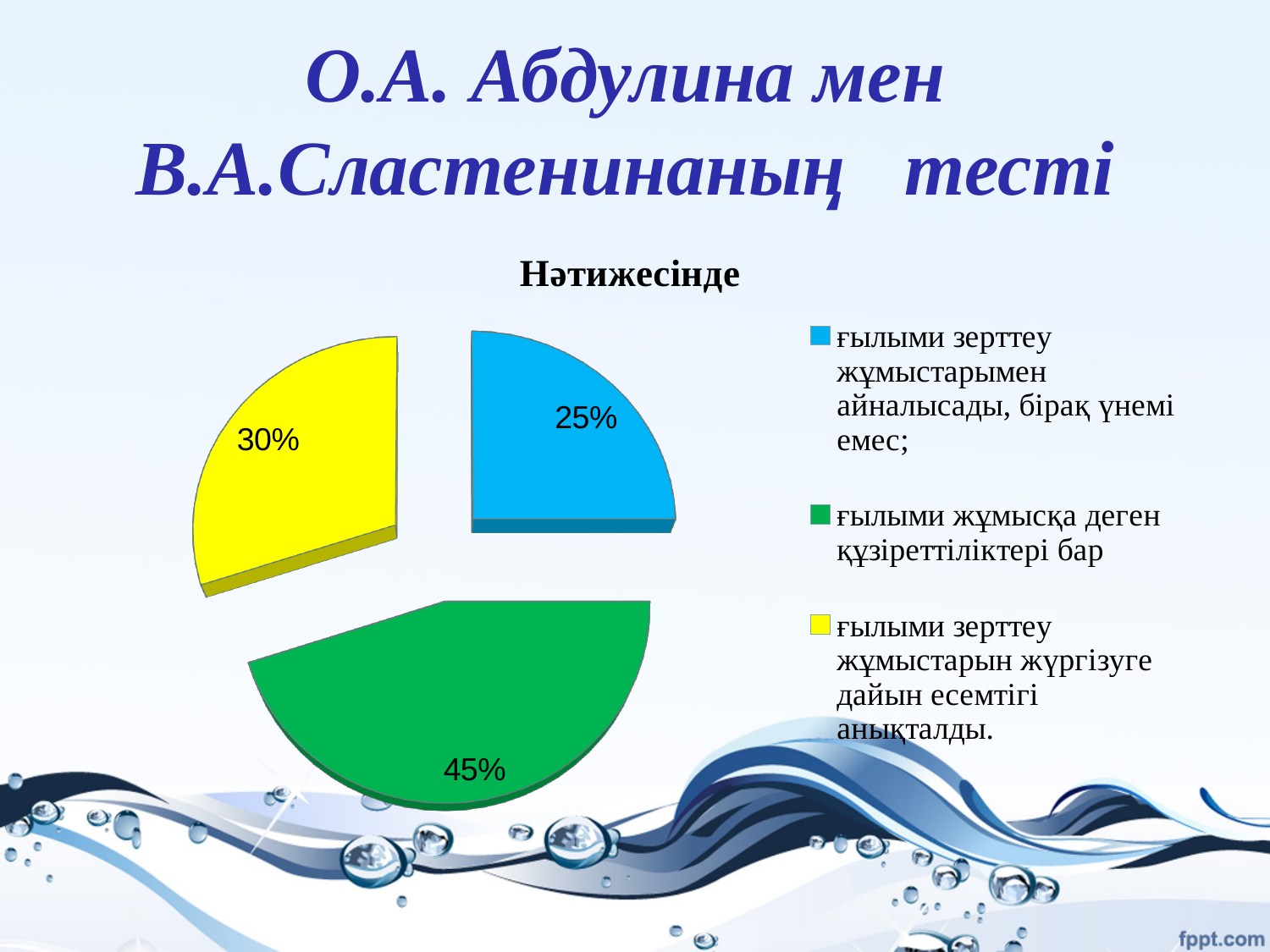
What colour is the slice labelled 45%? Green Which is larger: the yellow slice or the blue slice? The yellow slice (30%) What percentage is shown for the slice "ғылыми жұмысқа деген құзіреттіліктері бар"? 45% What is the title of the chart? Нәтижесінде How many slices does the pie chart have? 3 Which category has the smallest share of the pie? ғылыми зерттеу жұмыстарымен айналысады, бірақ үнемі емес What kind of chart is shown on the slide? Pie chart What is the difference in percentage points between the green slice (45%) and the blue slice (25%)? 20 What percentage is shown for the slice "ғылыми зерттеу жұмыстарымен айналысады, бірақ үнемі емес"? 25% Which category has the largest share of the pie? ғылыми жұмысқа деген құзіреттіліктері бар What is the share of the pie for the yellow slice? 30% What percentage is shown for the slice "ғылыми зерттеу жұмыстарын жүргізуге дайын есемтігі анықталды"? 30%